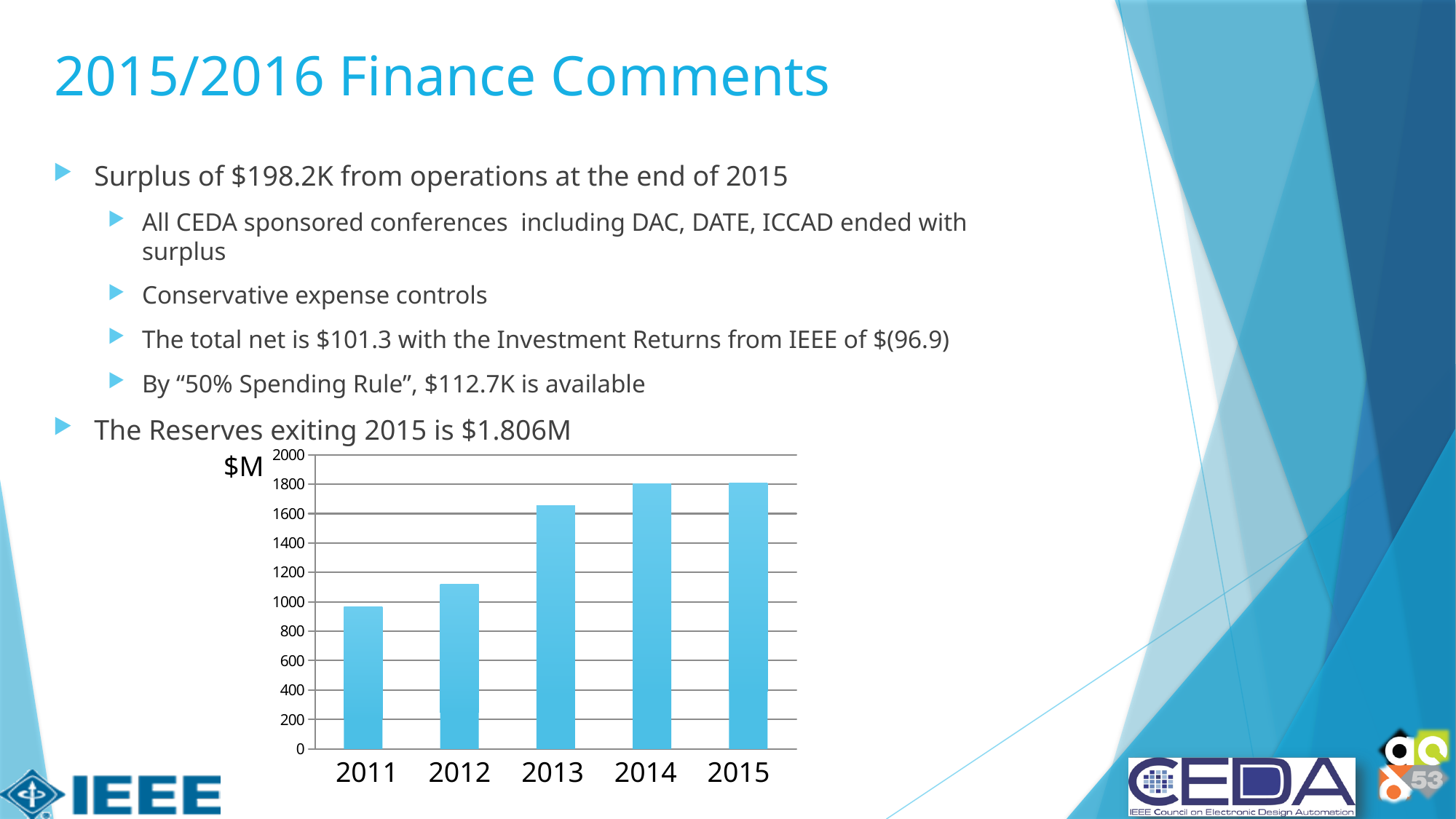
What kind of chart is shown on the slide? bar chart Is the value for 2014 greater or less than 1600? greater What unit label is shown next to the vertical axis of the chart? $M Is the value for 2013 greater or less than 1600? greater Is the value for 2015 greater or less than 2000? less Which is larger, the value for 2012 or the value for 2014? 2014 How many years are plotted on the chart? 5 Which year has the lowest bar on the chart? 2011 Do the values on the chart rise or fall from 2011 to 2015? rise Which is larger, the value for 2011 or the value for 2013? 2013